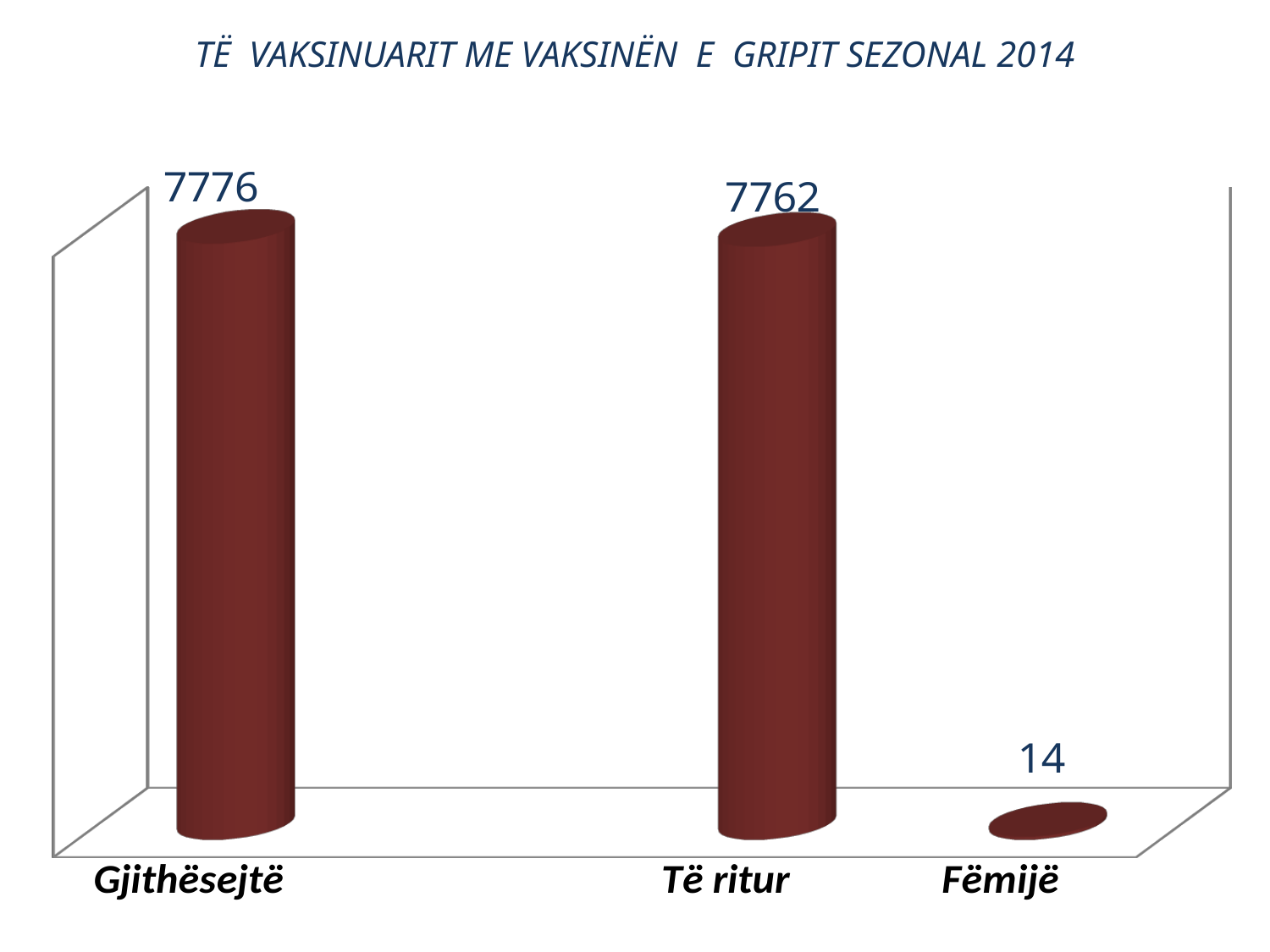
What is the value for Fëmijë? 14 What is the difference between the values for Gjithësejtë and Të ritur? 14 What is the value for Gjithësejtë? 7776 Which category has the lowest value? Fëmijë How many categories are shown on the chart? 3 What is the difference between the values for Të ritur and Fëmijë? 7748 What is the title of the chart? TË VAKSINUARIT ME VAKSINËN E GRIPIT SEZONAL 2014 Which is larger, the value for Të ritur or the value for Fëmijë? Të ritur What kind of chart is shown on the slide? Bar chart What is the value for Të ritur? 7762 What colour are the bars in the chart? Dark red